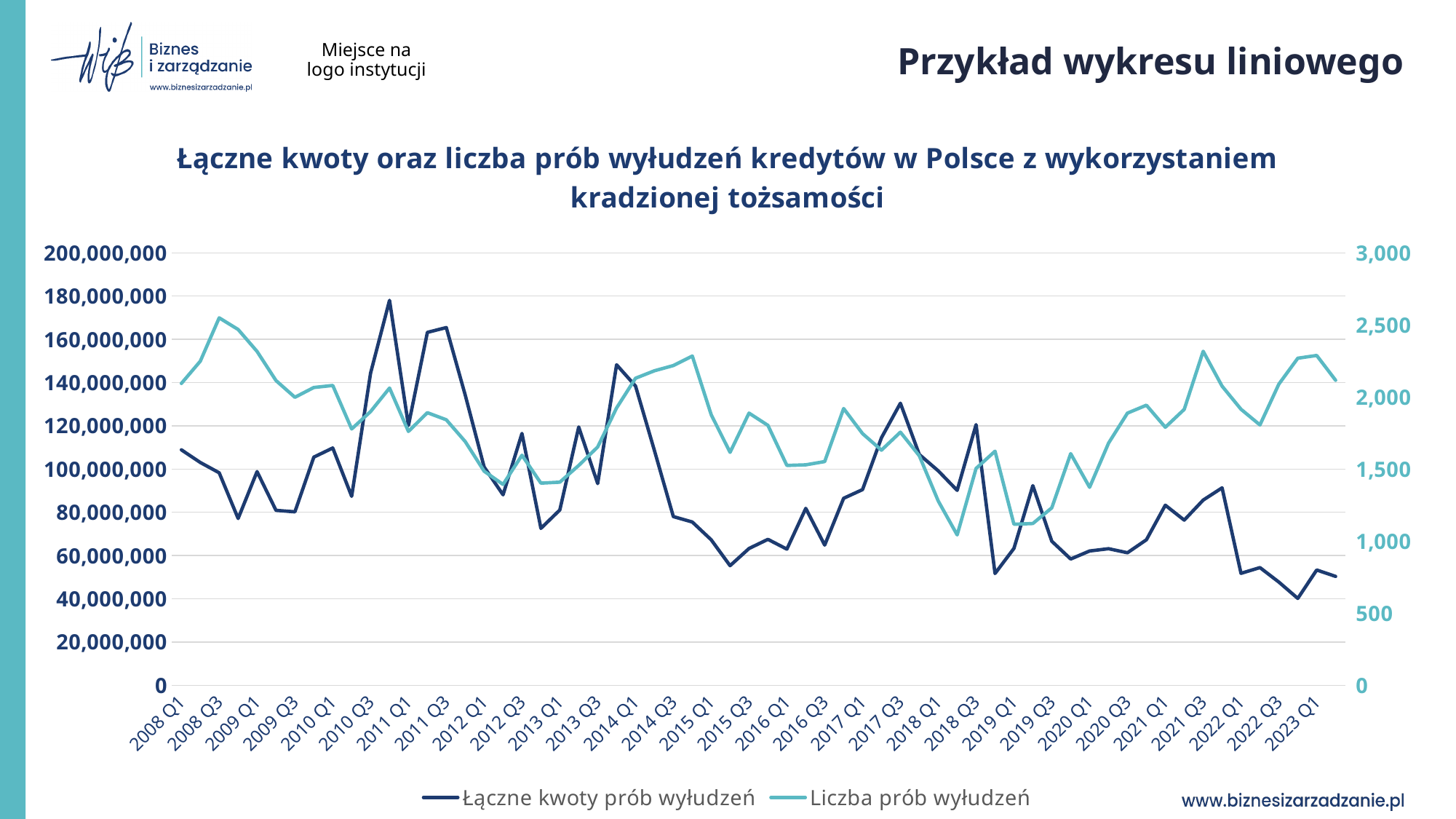
Overall, does 'Łączne kwoty prób wyłudzeń' rise or fall from 2008 Q1 to 2023 Q1? fall What kind of chart is shown on the slide? line chart What are the two series named in the legend? Łączne kwoty prób wyłudzeń; Liczba prób wyłudzeń Is the value of 'Liczba prób wyłudzeń' at 2008 Q3 greater or less than 2,000? greater Is the value of 'Łączne kwoty prób wyłudzeń' at 2011 Q1 greater or less than 160,000,000? less Which is larger for 'Łączne kwoty prób wyłudzeń': the value at 2011 Q1 or at 2023 Q1? 2011 Q1 Is the value of 'Łączne kwoty prób wyłudzeń' at 2008 Q1 greater or less than 100,000,000? greater What is the maximum value shown on the right-hand axis? 3,000 How many series does the legend list? 2